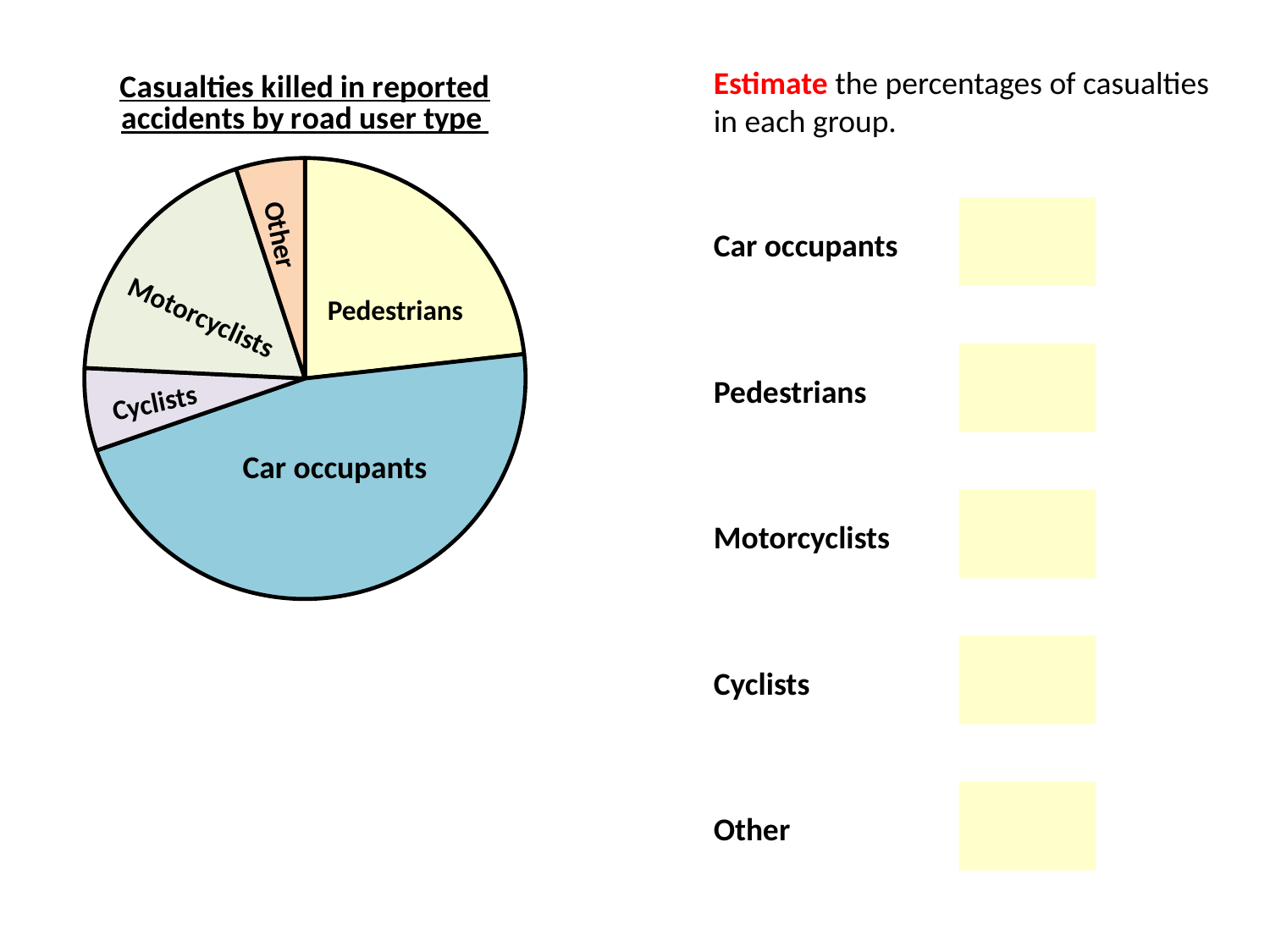
What colour is the Car occupants slice of the pie chart? blue Which slice is larger, Pedestrians or Other? Pedestrians Which slice is larger, Motorcyclists or Cyclists? Motorcyclists Which road user type has the largest slice of the pie chart? Car occupants Which slice is larger, Car occupants or Motorcyclists? Car occupants How many slices does the pie chart have? 5 What kind of chart is shown on the slide? pie chart What is the title of the pie chart? Casualties killed in reported accidents by road user type